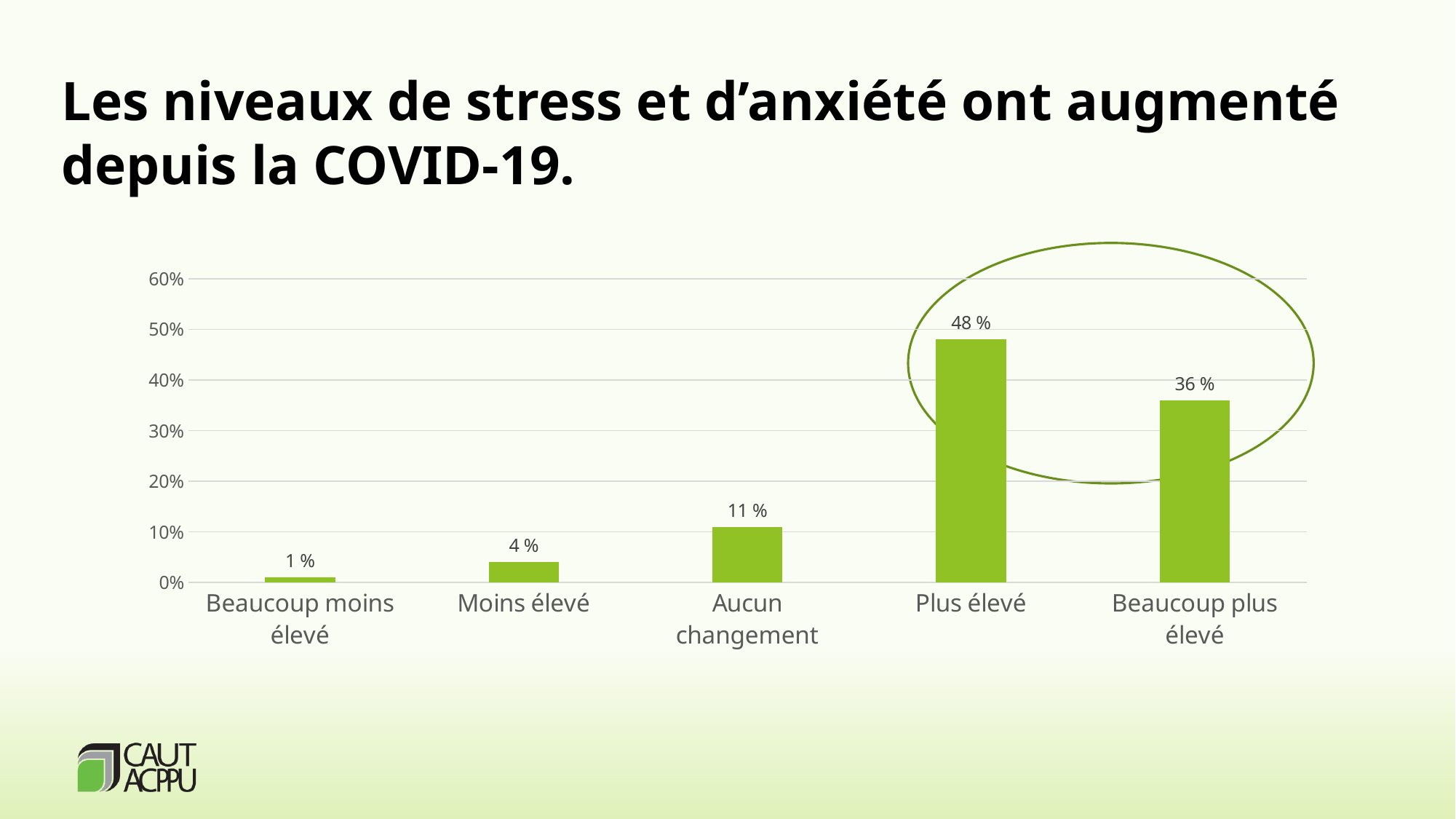
Which category has the lowest value? Beaucoup moins élevé How many categories are shown on the x axis? 5 What is the value for "Moins élevé"? 4 % What kind of chart is shown on the slide? bar chart What is the value for "Plus élevé"? 48 % What is the total of the values for "Plus élevé" and "Beaucoup plus élevé"? 84 % What is the value for "Aucun changement"? 11 % Which is larger, the value for "Aucun changement" or the value for "Moins élevé"? Aucun changement What is the difference between the values for "Plus élevé" and "Beaucoup plus élevé"? 12 % What is the value for "Beaucoup plus élevé"? 36 % Which category has the highest value? Plus élevé Is the value for "Beaucoup plus élevé" greater or less than 30%? greater